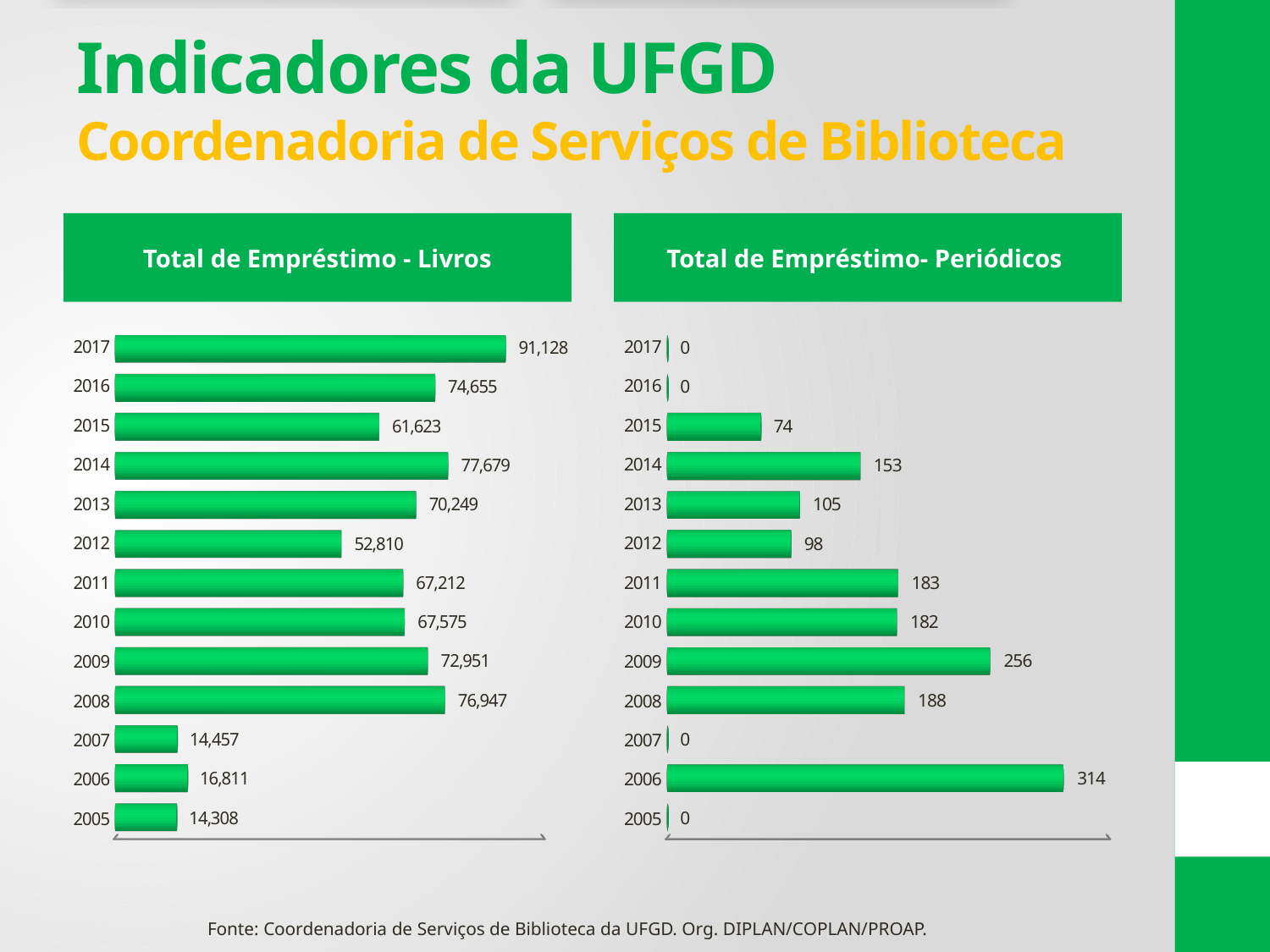
What kind of chart is the 'Total de Empréstimo- Periódicos' chart? Bar chart In the 'Total de Empréstimo- Periódicos' chart, which is larger, the value for 2014 or the value for 2013? 2014 In the 'Total de Empréstimo- Periódicos' chart, what is the difference between the values for 2006 and 2009? 58 In the 'Total de Empréstimo- Periódicos' chart, what is the value for 2009? 256 In the 'Total de Empréstimo- Periódicos' chart, how many years have a value of 0? 4 In the 'Total de Empréstimo - Livros' chart, which year has the lowest value? 2005 In the 'Total de Empréstimo - Livros' chart, which year has the highest value? 2017 In the 'Total de Empréstimo - Livros' chart, what is the difference between the values for 2017 and 2016? 16,473 In the 'Total de Empréstimo - Livros' chart, what is the value for 2017? 91,128 How many years are shown in the 'Total de Empréstimo - Livros' chart? 13 In the 'Total de Empréstimo - Livros' chart, which is larger, the value for 2014 or the value for 2015? 2014 In the 'Total de Empréstimo- Periódicos' chart, which year has the highest value? 2006